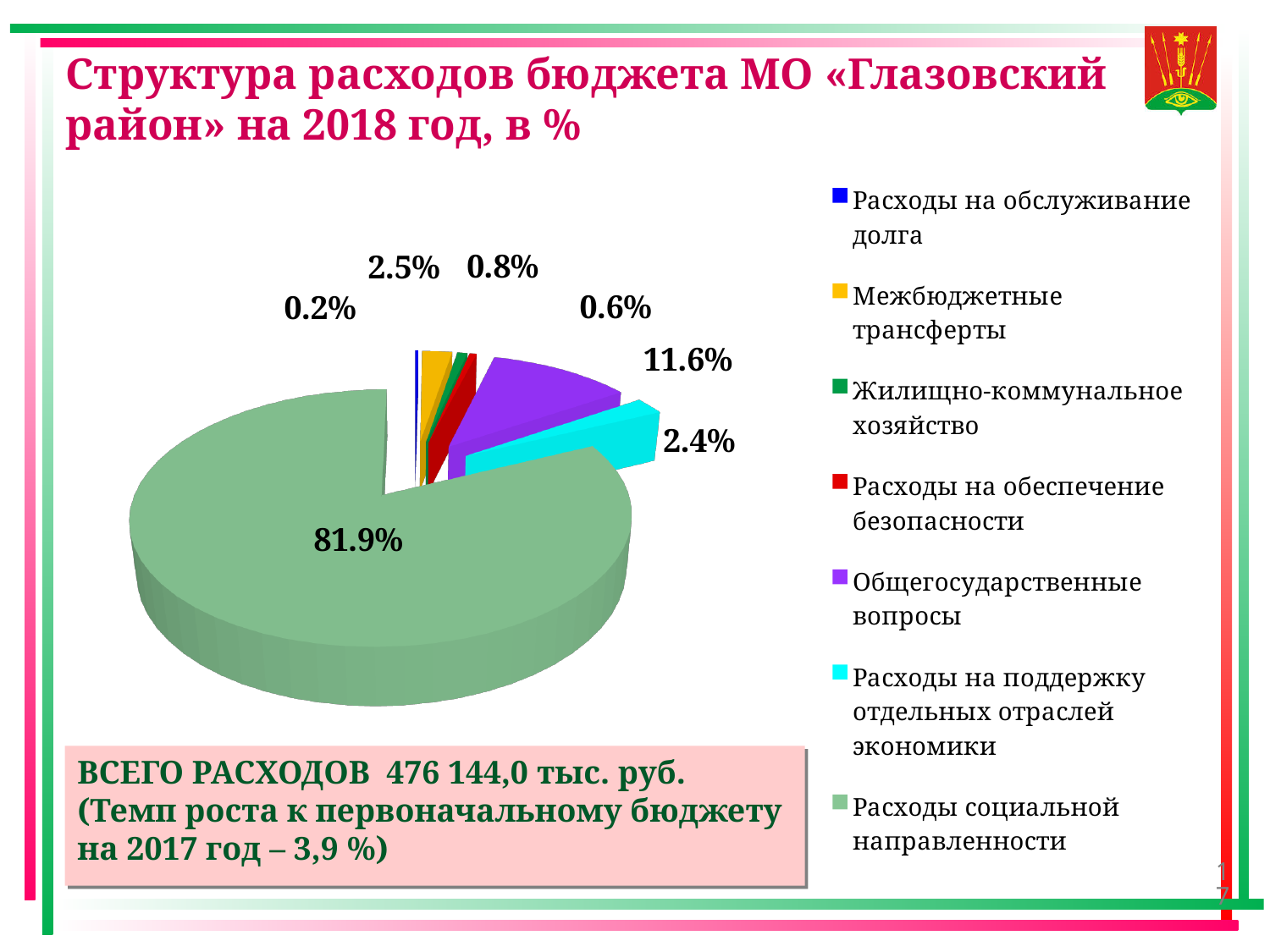
What share of the pie is labelled for Общегосударственные вопросы? 11.6% Which category has the smallest slice of the pie? Расходы на обслуживание долга What share of the pie is labelled for Расходы на обслуживание долга? 0.2% What share of the pie is labelled for Расходы на поддержку отдельных отраслей экономики? 2.4% What type of chart is shown on the slide? Pie chart What share of the pie is labelled for Межбюджетные трансферты? 2.5% What is the difference in percentage points between Расходы социальной направленности and Общегосударственные вопросы? 70.3 How many categories does the legend list? 7 What colour is the slice for Расходы социальной направленности? Light green Which is larger: the slice for Общегосударственные вопросы or the slice for Расходы на поддержку отдельных отраслей экономики? Общегосударственные вопросы What share of the pie is labelled for Расходы социальной направленности? 81.9% Which category has the largest slice of the pie? Расходы социальной направленности